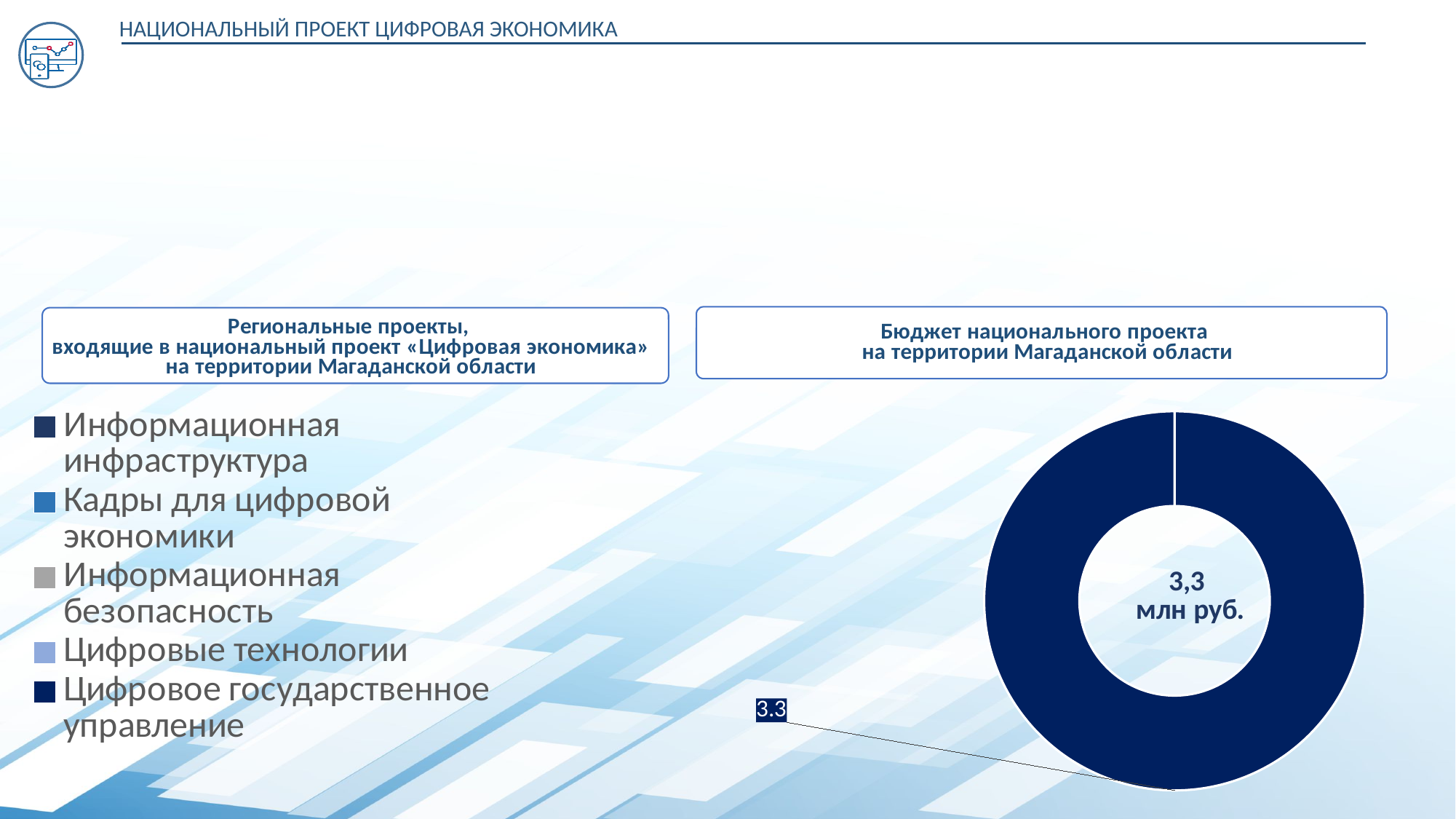
What value is printed on the data label attached to the donut chart? 3.3 What kind of chart is shown under the heading «Бюджет национального проекта на территории Магаданской области»? Pie chart (donut) Is the value shown on the donut chart's data label greater or less than 3? greater Which legend entry is listed last? Цифровое государственное управление What is the title of the box above the donut chart? Бюджет национального проекта на территории Магаданской области What text is shown in the centre of the donut chart? 3,3 млн руб. How many entries does the legend on the left of the slide list? 5 How many visibly separate slices does the donut chart show? 1